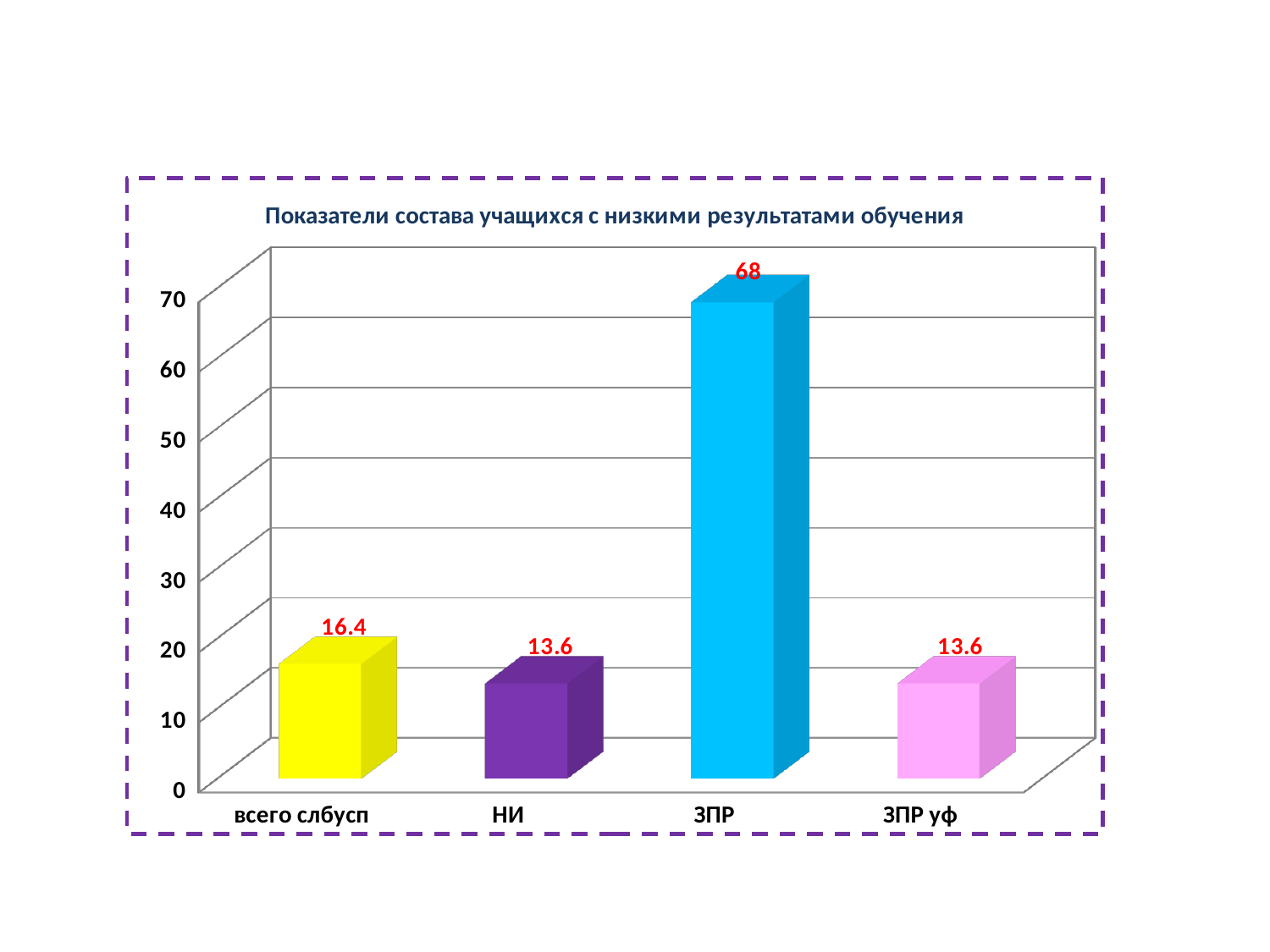
What is the value for НИ? 13.6 What is the value for ЗПР уф? 13.6 What is the difference between the values for всего слбусп and НИ? 2.8 How many categories are shown on the x axis? 4 What kind of chart is shown on the slide? bar chart What is the title of the chart? Показатели состава учащихся с низкими результатами обучения What is the difference between the values for ЗПР and всего слбусп? 51.6 Which category has the highest value? ЗПР What is the value for всего слбусп? 16.4 Which is larger, the value for всего слбусп or the value for ЗПР уф? всего слбусп What is the value for ЗПР? 68 Is the value for ЗПР greater or less than 60? greater